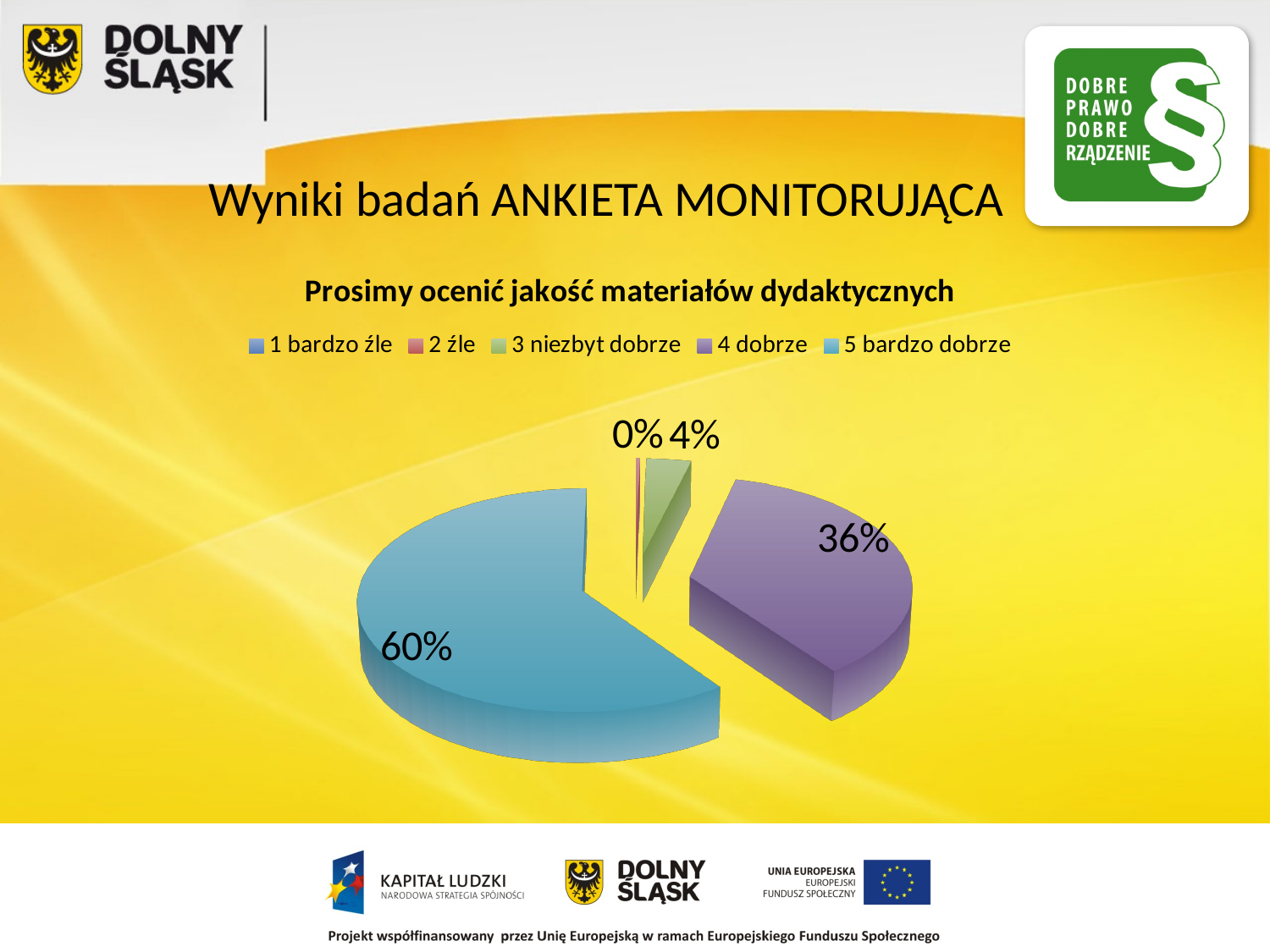
Which category has the largest slice of the pie? 5 bardzo dobrze What share of the pie is labelled for '5 bardzo dobrze'? 60% What is the difference in percentage points between the '5 bardzo dobrze' slice and the '4 dobrze' slice? 24 What is the difference in percentage points between the '4 dobrze' slice and the '3 niezbyt dobrze' slice? 32 Which is larger, the slice for '3 niezbyt dobrze' or the slice for '4 dobrze'? 4 dobrze What share of the pie is labelled for '4 dobrze'? 36% What type of chart is shown on the slide? pie chart What is the title of the chart? Prosimy ocenić jakość materiałów dydaktycznych Which is larger, the slice for '4 dobrze' or the slice for '5 bardzo dobrze'? 5 bardzo dobrze How many entries does the chart legend list? 5 What colour is the slice for '5 bardzo dobrze'? blue (light blue) What share of the pie is labelled for '3 niezbyt dobrze'? 4%